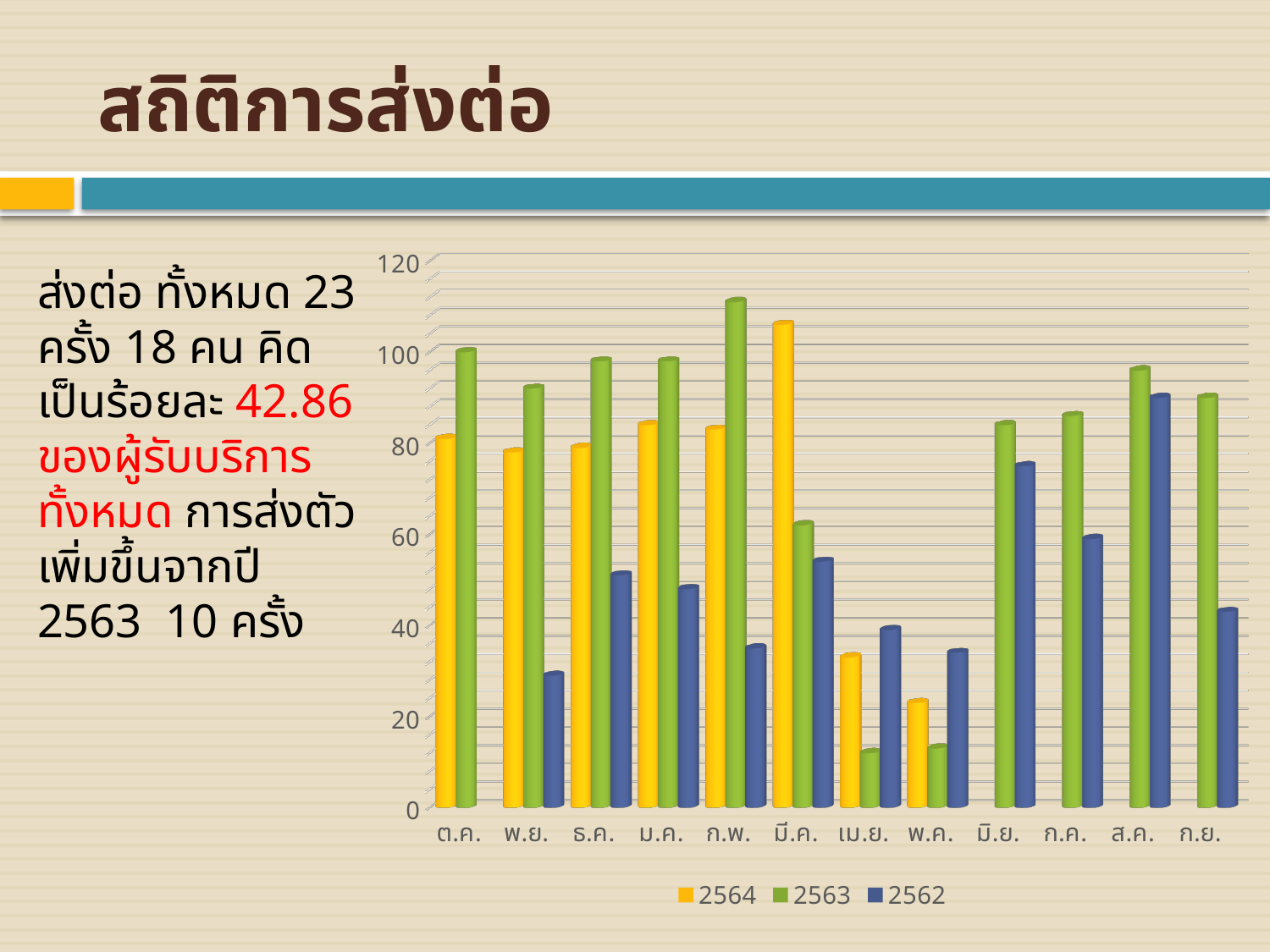
Which month has the highest value for the 2563 series? ก.พ. How many series does the chart legend list? 3 Which colour represents the 2563 series in the chart legend? green In มี.ค., which series has the larger value, 2564 or 2563? 2564 Is the value for 2563 in ก.พ. greater or less than 100? greater Is the value for 2564 in เม.ย. greater or less than 40? less How many month categories are shown on the x axis of the chart? 12 Is the value for 2563 in เม.ย. greater or less than 20? less Which month has the highest value for the 2562 series? ส.ค. Which month has the highest value for the 2564 series? มี.ค. What kind of chart is shown on the slide? bar chart Which month has the lowest value for the 2564 series? พ.ค.